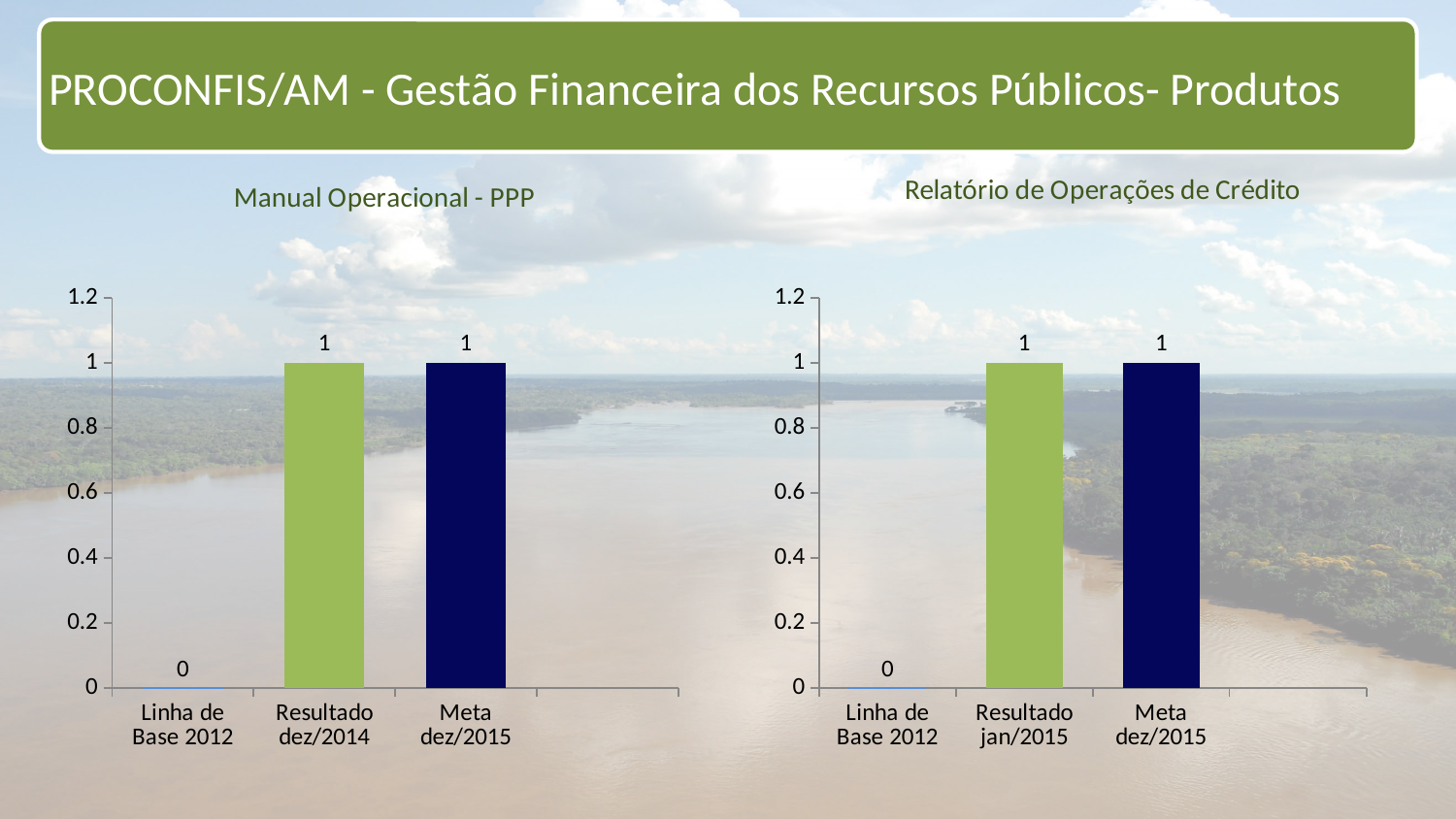
In the 'Relatório de Operações de Crédito' chart, which is larger: Resultado jan/2015 or Linha de Base 2012? Resultado jan/2015 In the 'Relatório de Operações de Crédito' chart, what is the value for Linha de Base 2012? 0 In the 'Manual Operacional - PPP' chart, which category has the lowest value? Linha de Base 2012 In the 'Relatório de Operações de Crédito' chart, what is the label of the middle category? Resultado jan/2015 In the 'Manual Operacional - PPP' chart, what is the difference between Meta dez/2015 and Linha de Base 2012? 1 In the 'Manual Operacional - PPP' chart, what is the value for Resultado dez/2014? 1 What kind of chart is the 'Relatório de Operações de Crédito' chart? Bar chart In the 'Manual Operacional - PPP' chart, what is the value for Linha de Base 2012? 0 In the 'Relatório de Operações de Crédito' chart, what is the value for Meta dez/2015? 1 How many categories are shown in the 'Manual Operacional - PPP' chart? 3 What is the title of the chart on the left side of the slide? Manual Operacional - PPP In the 'Relatório de Operações de Crédito' chart, which category has the lowest value? Linha de Base 2012